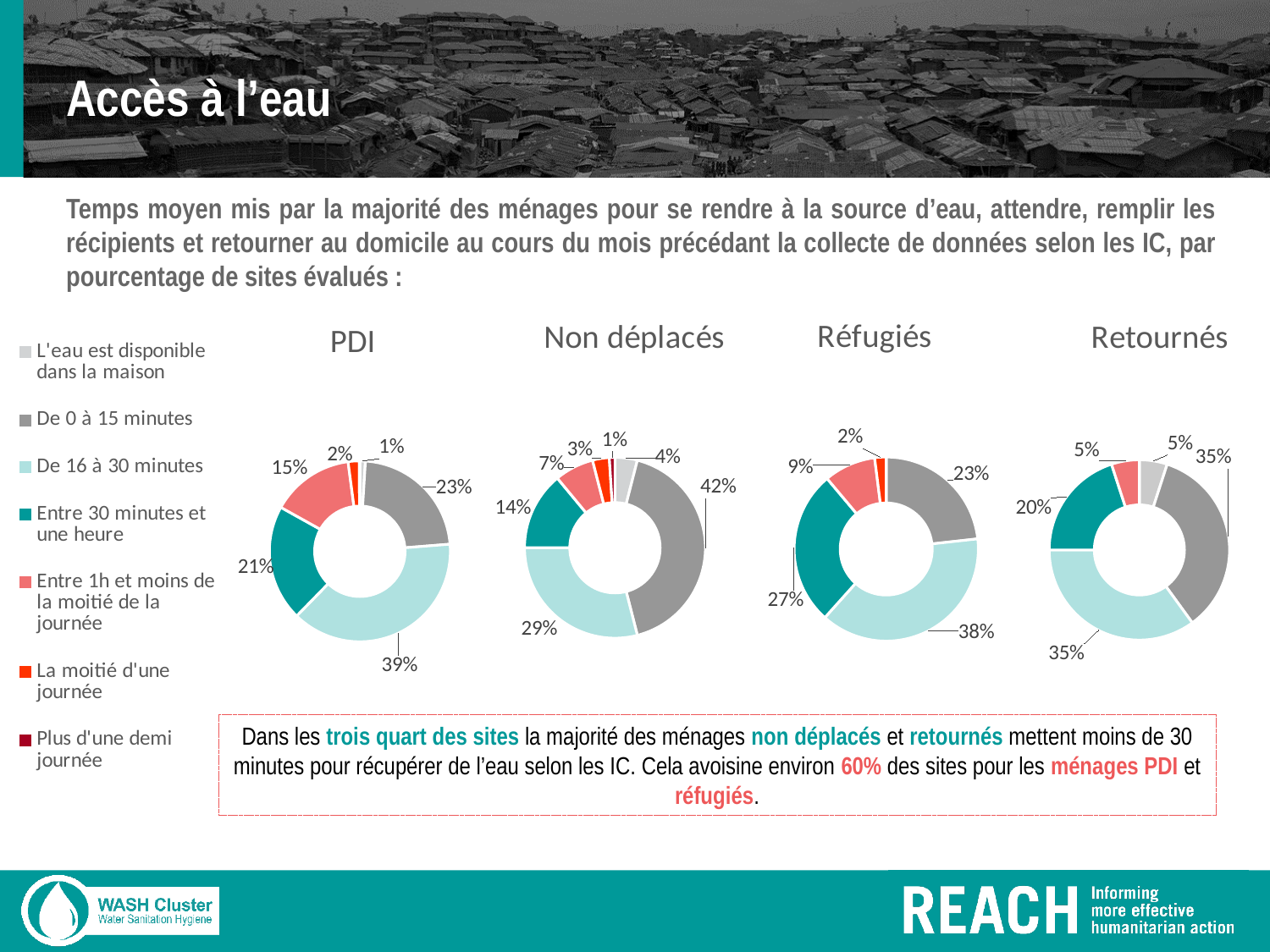
In the Réfugiés chart, what is the smallest slice's value? 2% In the Réfugiés chart, what is the largest slice's value? 38% What kind of charts are shown on the slide? Pie (donut) charts How many categories does the legend list? 7 In the Non déplacés chart, what is the largest slice's value? 42% In the PDI chart, what is the difference between the 39% slice and the 23% slice? 16% Which is larger in the Réfugiés chart: the 'De 0 à 15 minutes' slice or the 'Entre 30 minutes et une heure' slice? Entre 30 minutes et une heure What are the titles of the four donut charts, from left to right? PDI, Non déplacés, Réfugiés, Retournés How many donut charts are shown on the slide? 4 In the Retournés chart, what percentage of sites is shown for 'Entre 30 minutes et une heure'? 20% In the PDI chart, what is the largest slice's value? 39% In the Non déplacés chart, what percentage of sites is shown for 'De 16 à 30 minutes'? 29%